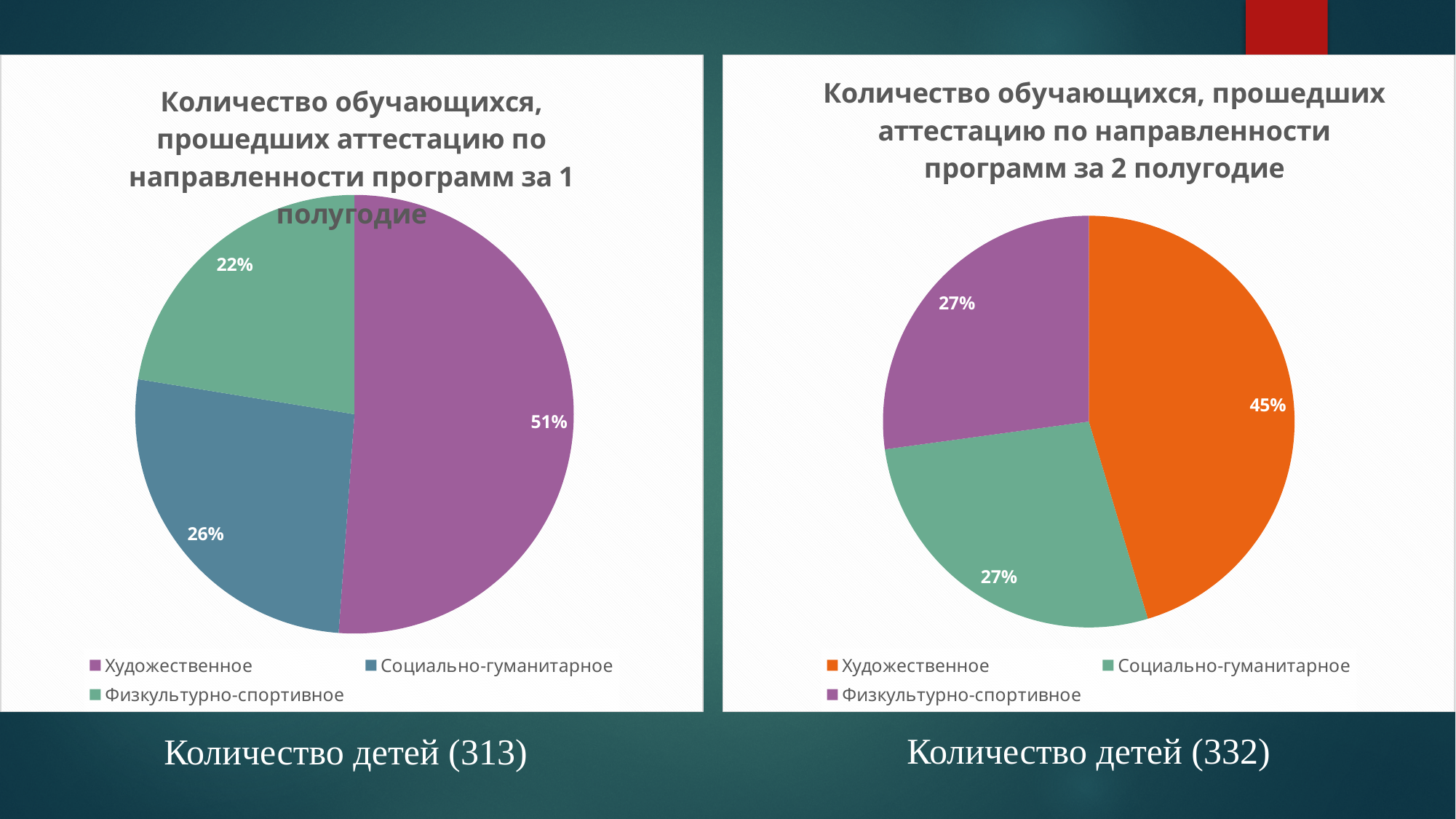
What type of chart is used on the right side of the slide (2 полугодие)? pie chart In the right pie chart (2 полугодие), what is the difference in percentage points between Художественное and Физкультурно-спортивное? 18 In the right pie chart (2 полугодие), what share is labelled for Художественное? 45% Which chart shows a larger share for Художественное, the left (1 полугодие) or the right (2 полугодие)? the left (1 полугодие) In the left pie chart (1 полугодие), what share is labelled for Художественное? 51% In the left pie chart (1 полугодие), which category has the smallest slice? Физкультурно-спортивное In the left pie chart (1 полугодие), what is the difference in percentage points between Художественное and Социально-гуманитарное? 25 In the right pie chart (2 полугодие), what share is labelled for Социально-гуманитарное? 27% In the left pie chart (1 полугодие), what share is labelled for Социально-гуманитарное? 26% In the left pie chart (1 полугодие), what share is labelled for Физкультурно-спортивное? 22% In the right pie chart (2 полугодие), which category has the largest slice? Художественное How many categories does the legend of the left pie chart (1 полугодие) list? 3